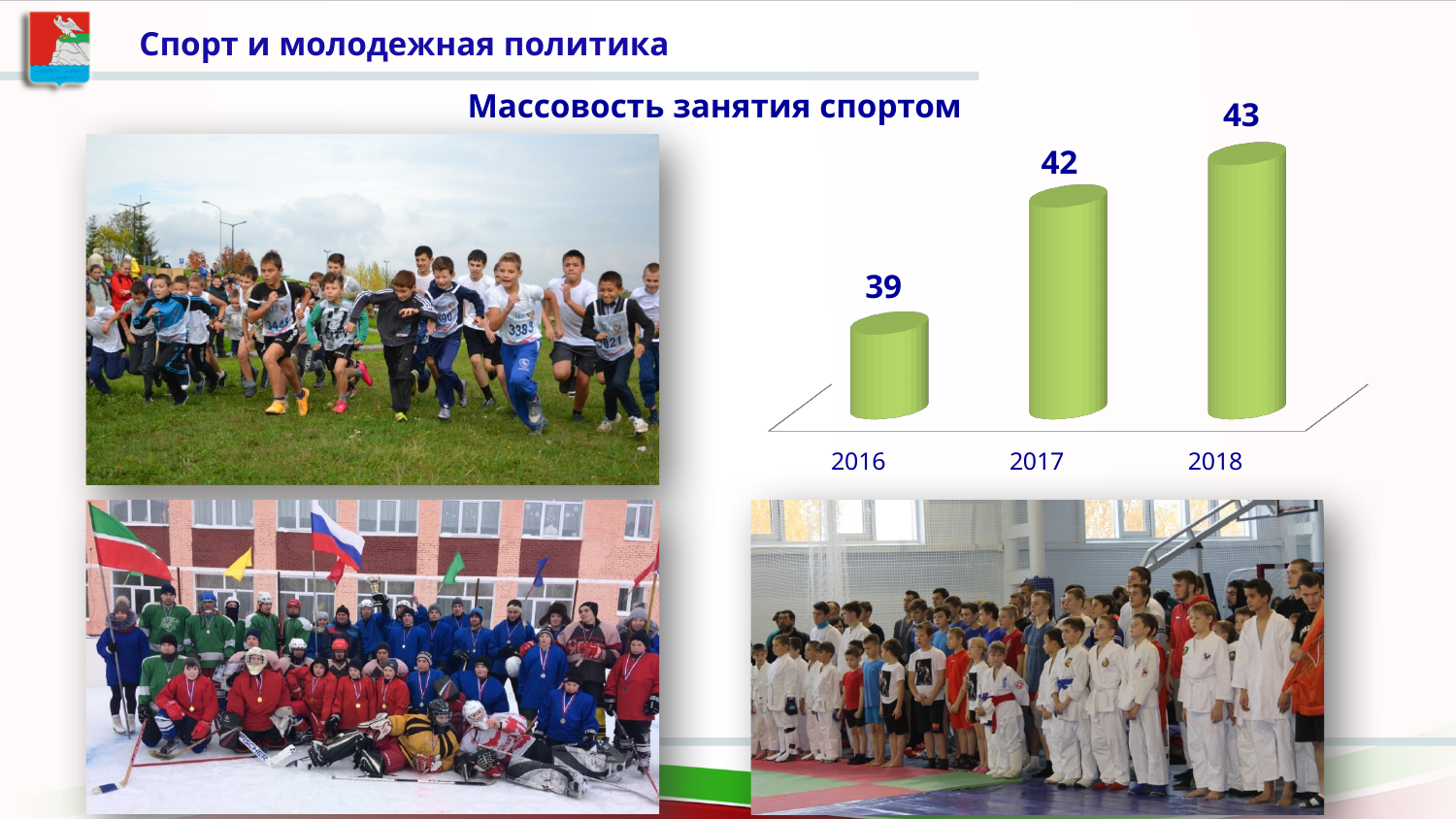
How many years are shown in the chart? 3 What is the difference between the values for 2018 and 2016? 4 What is the value for 2016 in the chart? 39 What is the value for 2017 in the chart? 42 Do the values rise or fall from 2016 to 2018? rise What is the title of the chart? Массовость занятия спортом Which year has the highest value in the chart? 2018 What kind of chart is shown on the slide? bar chart Which year has the lowest value in the chart? 2016 What is the value for 2018 in the chart? 43 Which is larger, the value for 2016 or the value for 2017? 2017 What is the difference between the values for 2017 and 2016? 3